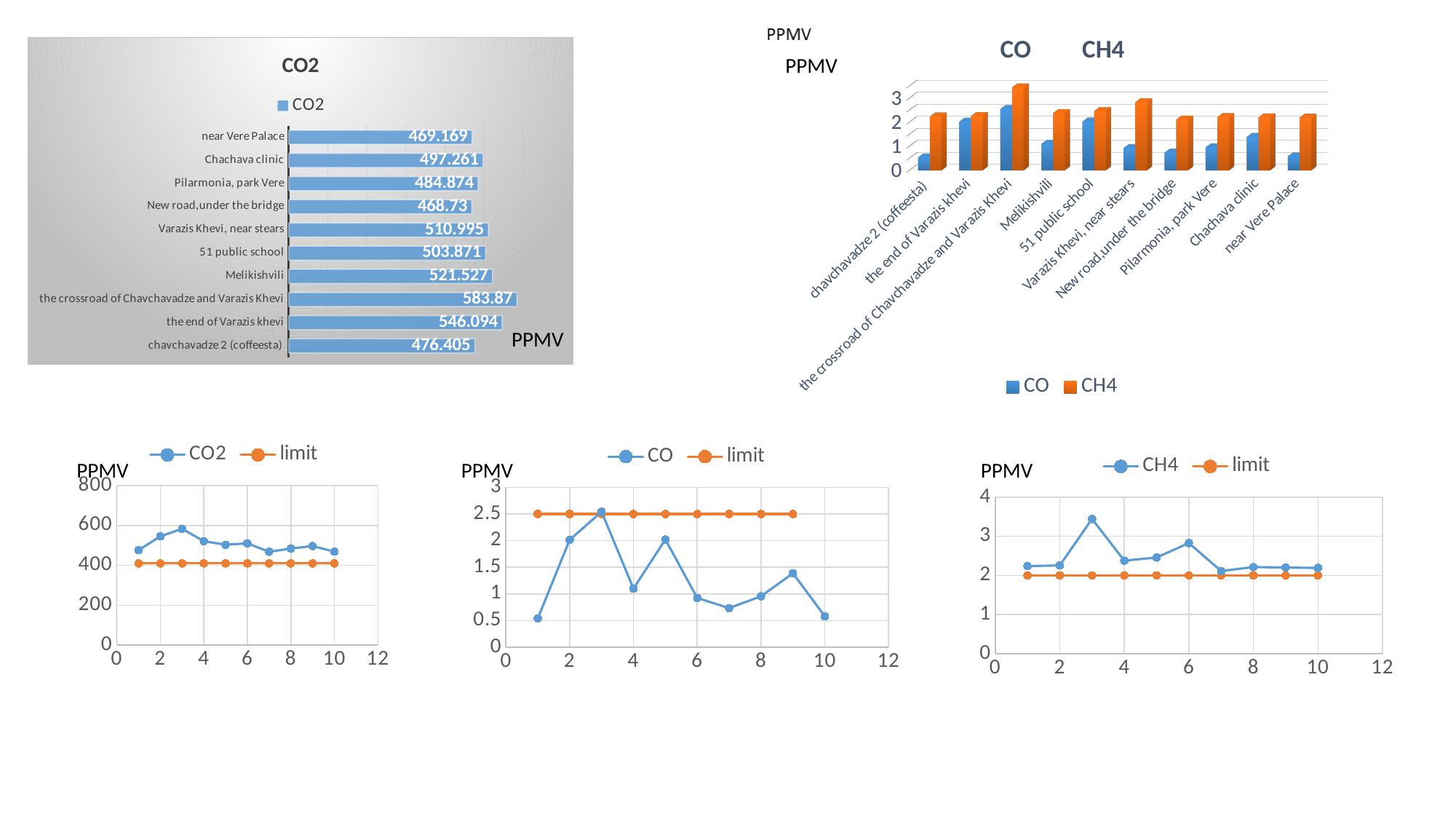
In the CO CH4 chart at the top right, which location has the highest CH4 value? the crossroad of Chavchavadze and Varazis Khevi In the CO CH4 chart at the top right, how many series does the legend list? 2 In the CO2 bar chart at the top left, which location has the highest CO2 value? the crossroad of Chavchavadze and Varazis Khevi In the CO CH4 chart at the top right, is the CO value for chavchavadze 2 (coffeesta) greater or less than 1? less In the CO2 bar chart at the top left, what is the difference between the values for the crossroad of Chavchavadze and Varazis Khevi and the end of Varazis khevi? 37.776 In the CO2 bar chart at the top left, how many locations are shown? 10 In the CO2 bar chart at the top left, which is larger: the value for Varazis Khevi, near stears or the value for 51 public school? Varazis Khevi, near stears In the CO2 bar chart at the top left, what is the value for Chachava clinic? 497.261 In the CO2 bar chart at the top left, which location has the lowest CO2 value? New road,under the bridge In the CH4 and limit line chart at the bottom right, what value does the limit line sit at? 2 In the CO2 bar chart at the top left, what is the value for Melikishvili? 521.527 What kind of chart is the CO and limit chart at the bottom centre? line chart